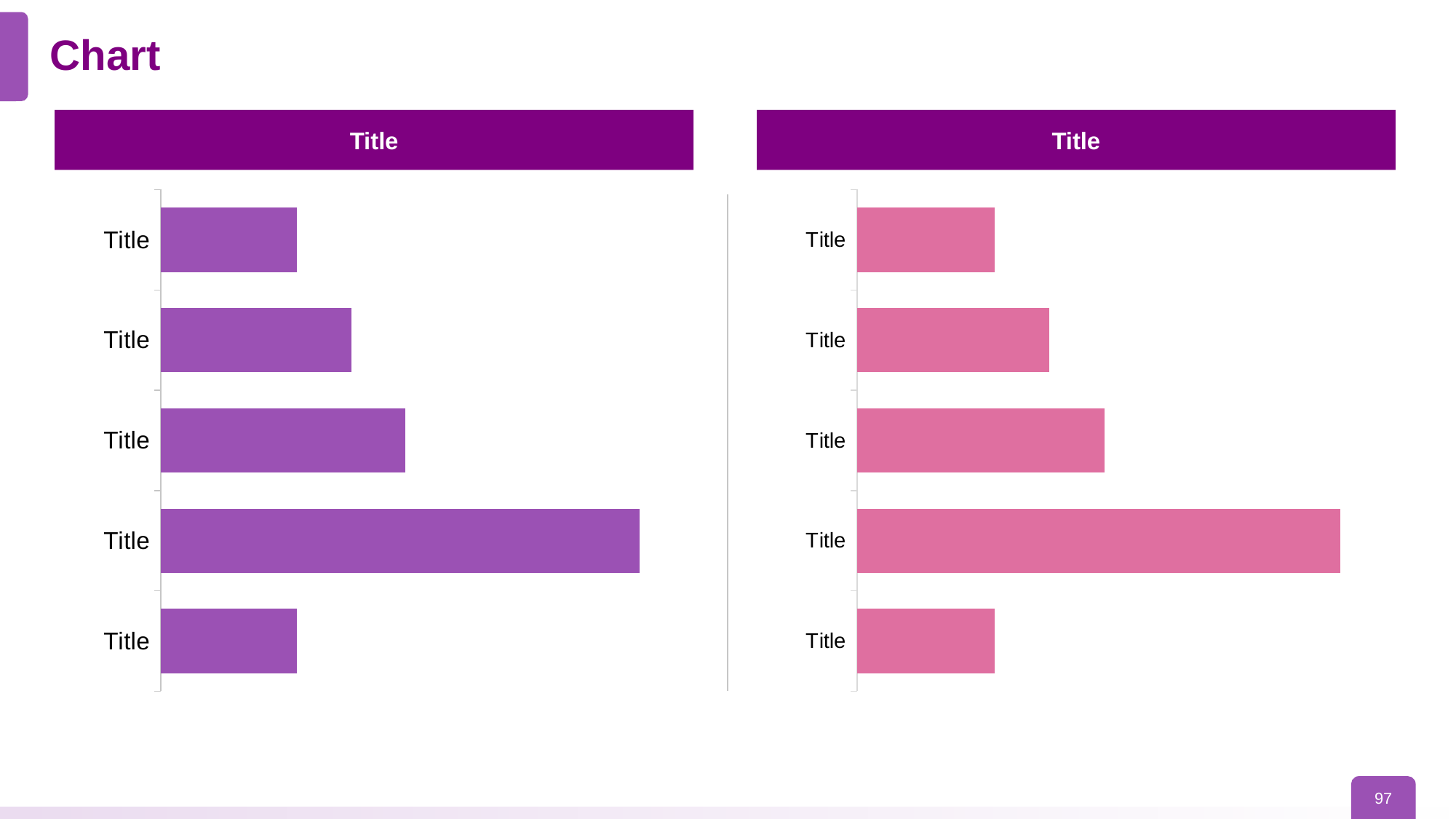
In the chart on the right side of the slide, which is longer: the third bar from the top or the fourth bar from the top? the fourth bar What kind of chart is the chart on the left side of the slide? bar chart What colour are the bars in the chart on the left side of the slide? purple In the chart on the left side of the slide, which is longer: the second bar from the top or the third bar from the top? the third bar In the chart on the right side of the slide, which bar is the longest, counting from the top? the fourth bar What is the title shown above the chart on the right side of the slide? Title What kind of chart is the chart on the right side of the slide? bar chart In the chart on the left side of the slide, which bar is the longest, counting from the top? the fourth bar How many bars does the chart on the right side of the slide have? 5 How many bars does the chart on the left side of the slide have? 5 In the chart on the right side of the slide, which is longer: the first bar from the top or the second bar from the top? the second bar